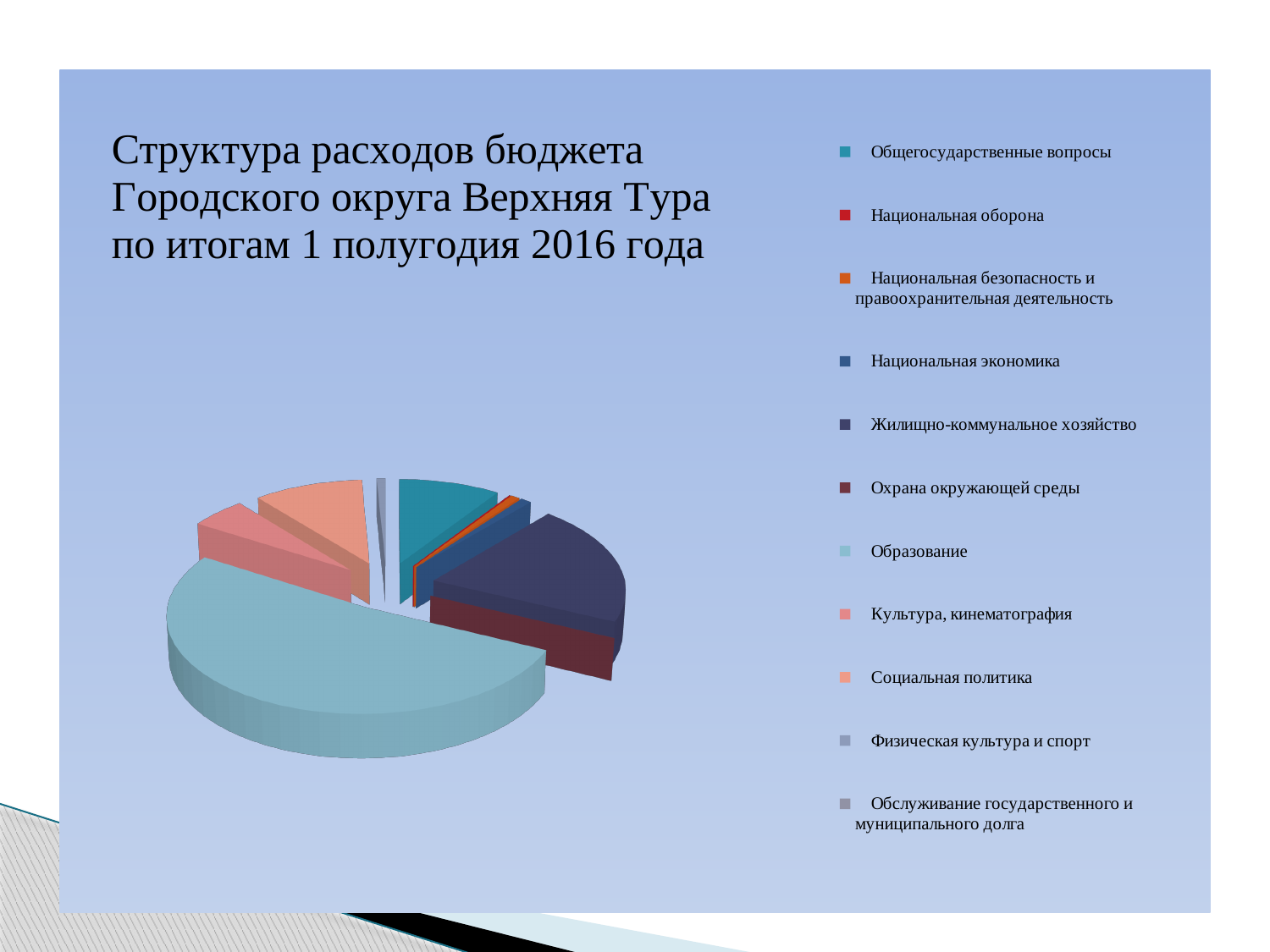
Which slice is larger, Образование or Социальная политика? Образование Which slice is larger, Культура, кинематография or Образование? Образование Which category is listed first in the legend? Общегосударственные вопросы What kind of chart is shown on the slide? pie chart What is the title of the chart on the slide? Структура расходов бюджета Городского округа Верхняя Тура по итогам 1 полугодия 2016 года Which slice is larger, Национальная экономика or Образование? Образование Which category has the largest slice in the pie chart? Образование How many categories does the legend of the pie chart list? 11